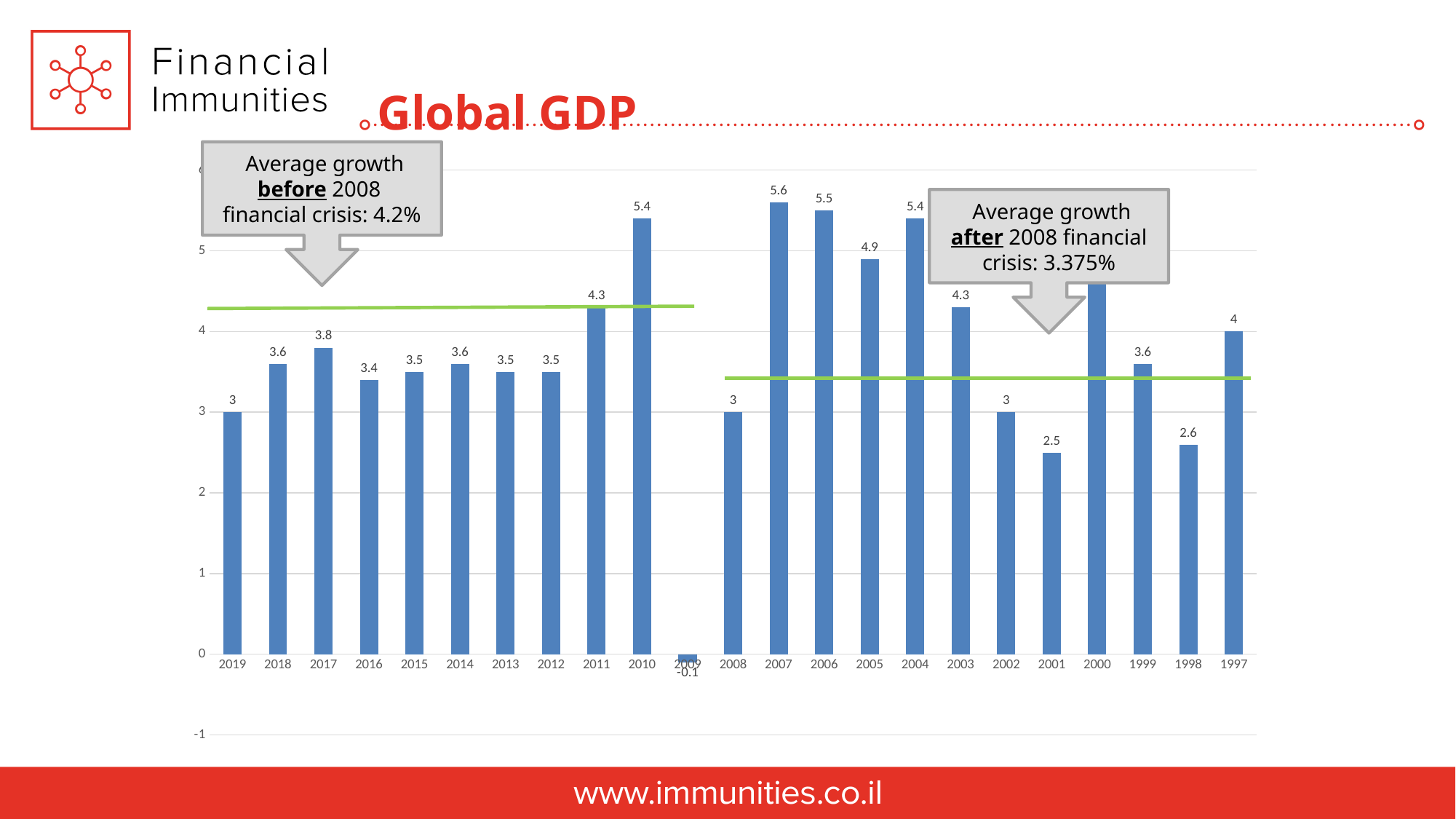
What is the value for 2001? 2.5 What is the value for 2010? 5.4 According to the callout, what was the average growth before the 2008 financial crisis? 4.2% Is the value for 2000 greater or less than 4? greater What is the difference between the values for 2007 and 2008? 2.6 What kind of chart is shown on the slide? Bar chart Which is larger, the value for 2017 or the value for 2016? 2017 What is the title of the chart? Global GDP Which year has the highest value? 2007 How many years are shown on the x axis? 23 Which year has the lowest value? 2009 What is the value for 2009? -0.1